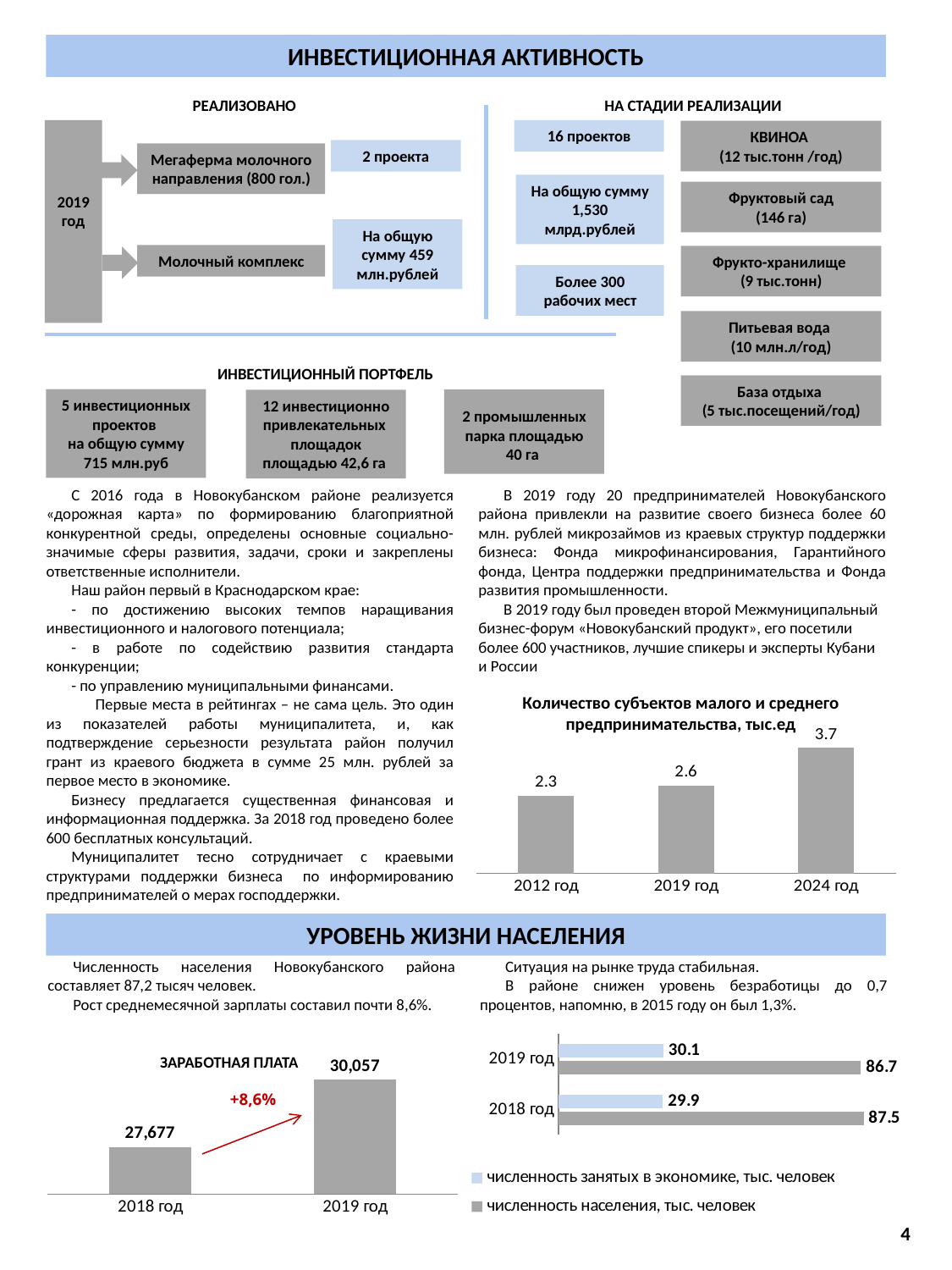
What kind of chart is 'ЗАРАБОТНАЯ ПЛАТА'? bar chart In the horizontal bar chart at the bottom right, how many series does the legend list? 2 In the chart 'ЗАРАБОТНАЯ ПЛАТА', what is the value for 2019 год? 30,057 In the chart 'Количество субъектов малого и среднего предпринимательства, тыс.ед', what is the difference between the values for 2024 год and 2012 год? 1.4 In the chart 'Количество субъектов малого и среднего предпринимательства, тыс.ед', what is the value for 2019 год? 2.6 In the chart 'Количество субъектов малого и среднего предпринимательства, тыс.ед', how many bars are plotted? 3 In the horizontal bar chart at the bottom right, what is the value of 'численность занятых в экономике, тыс. человек' for 2019 год? 30.1 In the horizontal bar chart at the bottom right, what is the value of 'численность населения, тыс. человек' for 2018 год? 87.5 In the chart 'ЗАРАБОТНАЯ ПЛАТА', what percentage change is shown between 2018 год and 2019 год? +8,6% In the chart 'ЗАРАБОТНАЯ ПЛАТА', what is the value for 2018 год? 27,677 In the chart 'Количество субъектов малого и среднего предпринимательства, тыс.ед', which year has the highest value? 2024 год In the chart 'Количество субъектов малого и среднего предпринимательства, тыс.ед', do the values rise or fall from 2012 год to 2024 год? rise